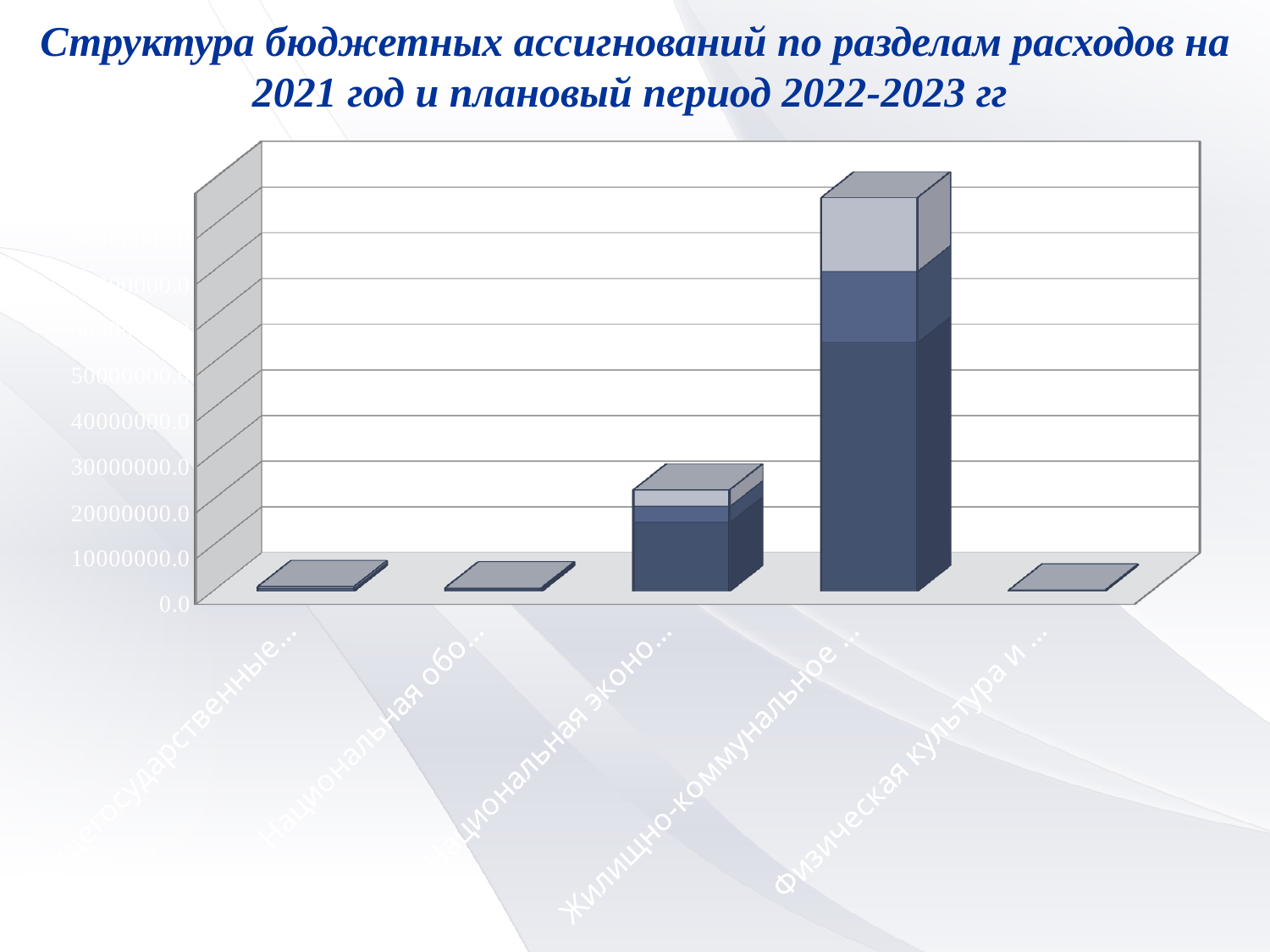
Which bar is taller: "Национальная эконо..." or "Национальная обо..."? Национальная эконо... What kind of chart is shown on the slide? bar chart Which category has the tallest bar in the chart? Жилищно-коммунальное ... Which bar is taller: "Жилищно-коммунальное ..." or "Национальная эконо..."? Жилищно-коммунальное ... Is the value of the bar for "Общегосударственные..." greater or less than 10000000.0? less Is the total value of the bar for "Национальная эконо..." greater or less than 10000000.0? greater How many categories are plotted along the x axis of the chart? 5 What is the title of the slide containing the chart? Структура бюджетных ассигнований по разделам расходов на 2021 год и плановый период 2022-2023 гг Is the value of the bar for "Физическая культура и ..." greater or less than 10000000.0? less How many stacked segments make up the bar for "Жилищно-коммунальное ..."? 3